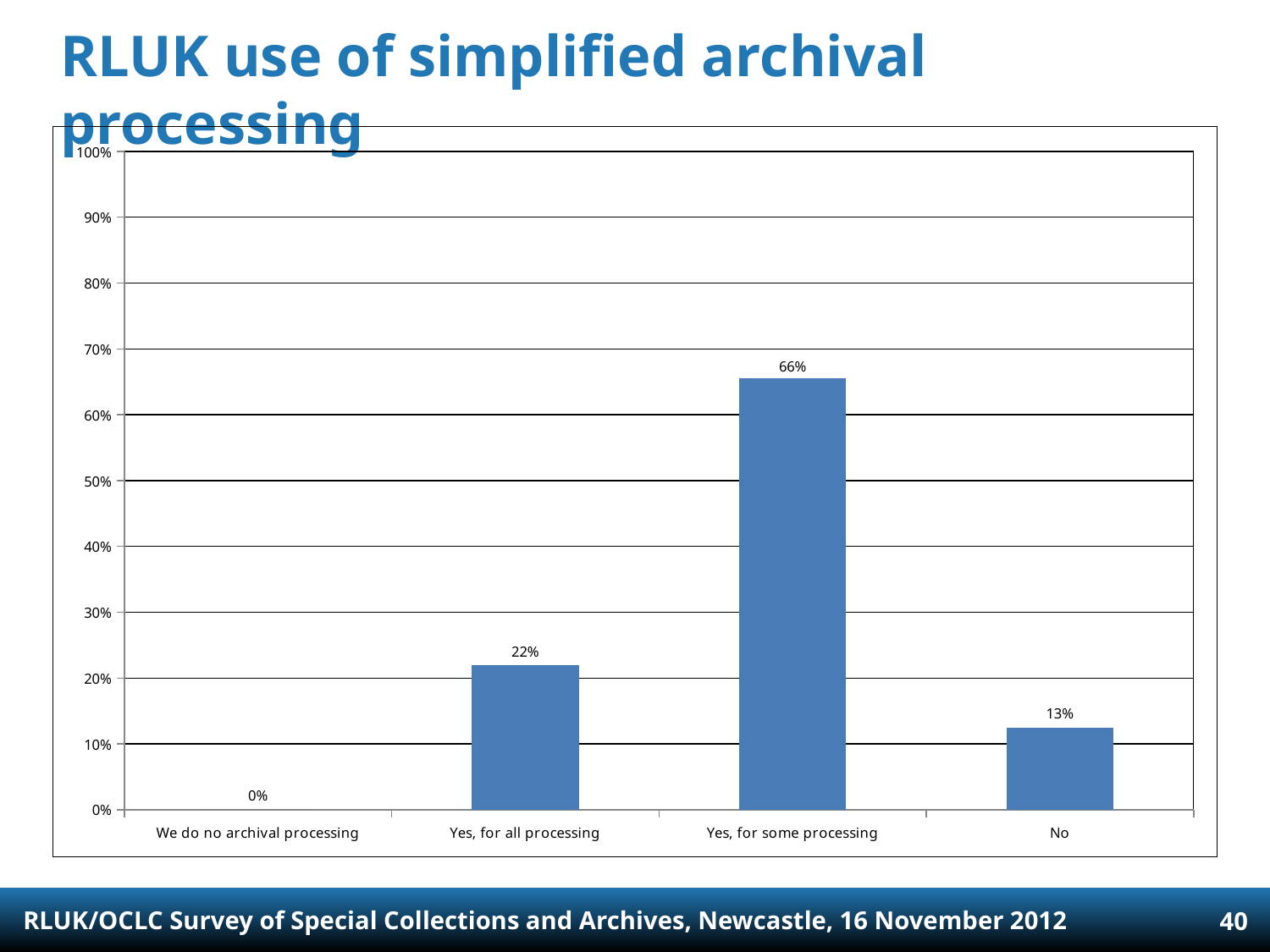
What is the value for "Yes, for some processing"? 66% What is the title of the slide containing the chart? RLUK use of simplified archival processing Which is larger, the value for "Yes, for all processing" or the value for "No"? Yes, for all processing How many categories are shown on the x axis? 4 What is the value for "Yes, for all processing"? 22% What is the value for "We do no archival processing"? 0% Which category has the highest value? Yes, for some processing Which category has the lowest value? We do no archival processing What is the difference between the values for "Yes, for some processing" and "Yes, for all processing"? 44% Is the value for "Yes, for some processing" greater or less than 60%? greater What kind of chart is shown on the slide? bar chart What is the value for "No"? 13%